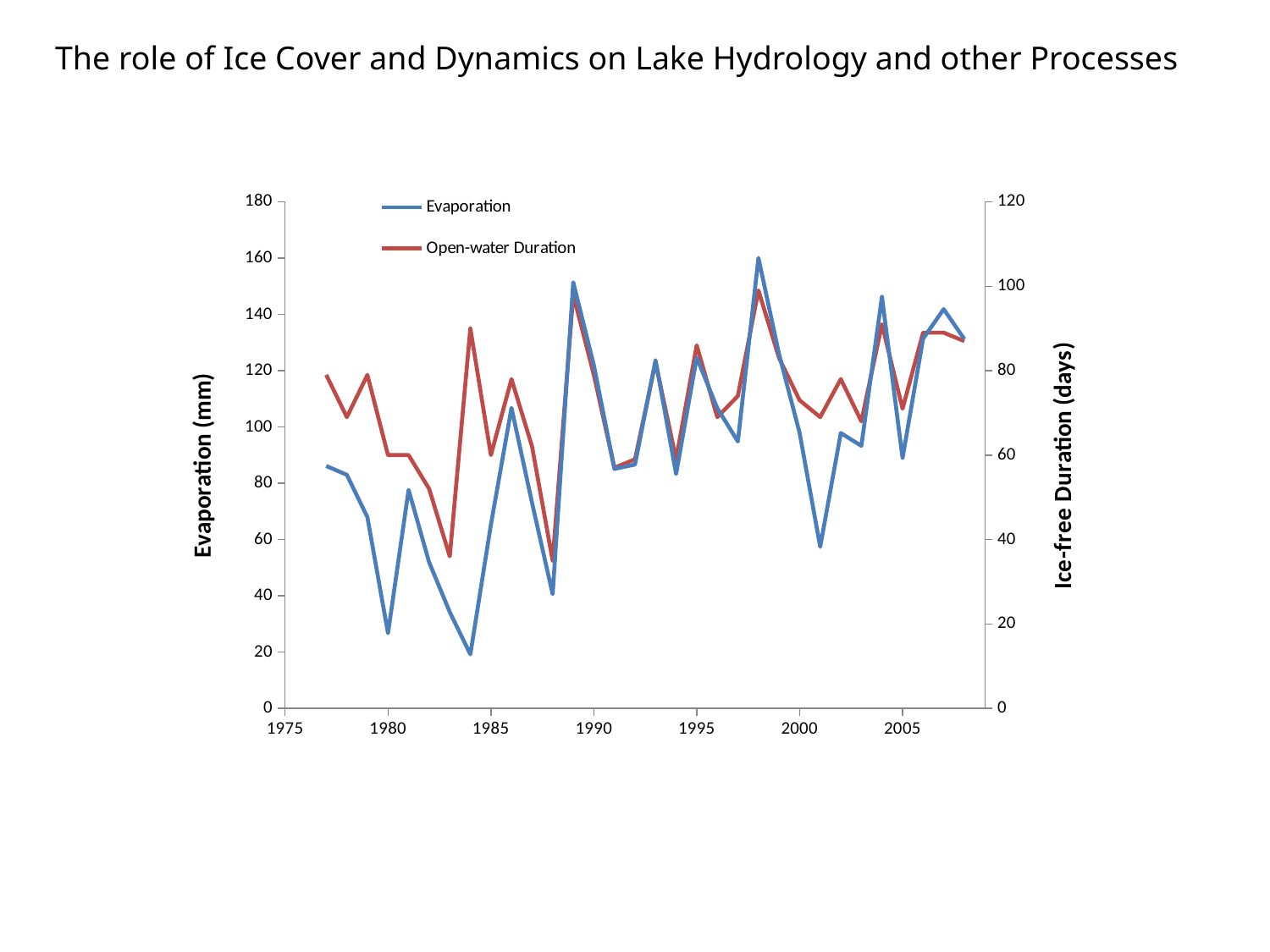
Does the Evaporation series generally rise or fall from 1977 to 2008? rise In which year does the Evaporation series reach its lowest value? 1984 Which year has the larger Evaporation value, 1980 or 1981? 1981 In which year does the Evaporation series reach its highest value? 1998 Is the Open-water Duration value for 1983 greater or less than 40 days? less Is the Evaporation value for 2001 greater or less than 80? less How many series does the chart's legend list? 2 What is the label on the right-hand vertical axis of the chart? Ice-free Duration (days) Is the Open-water Duration value for 1989 greater or less than 80 days? greater What kind of chart is shown on the slide? line chart